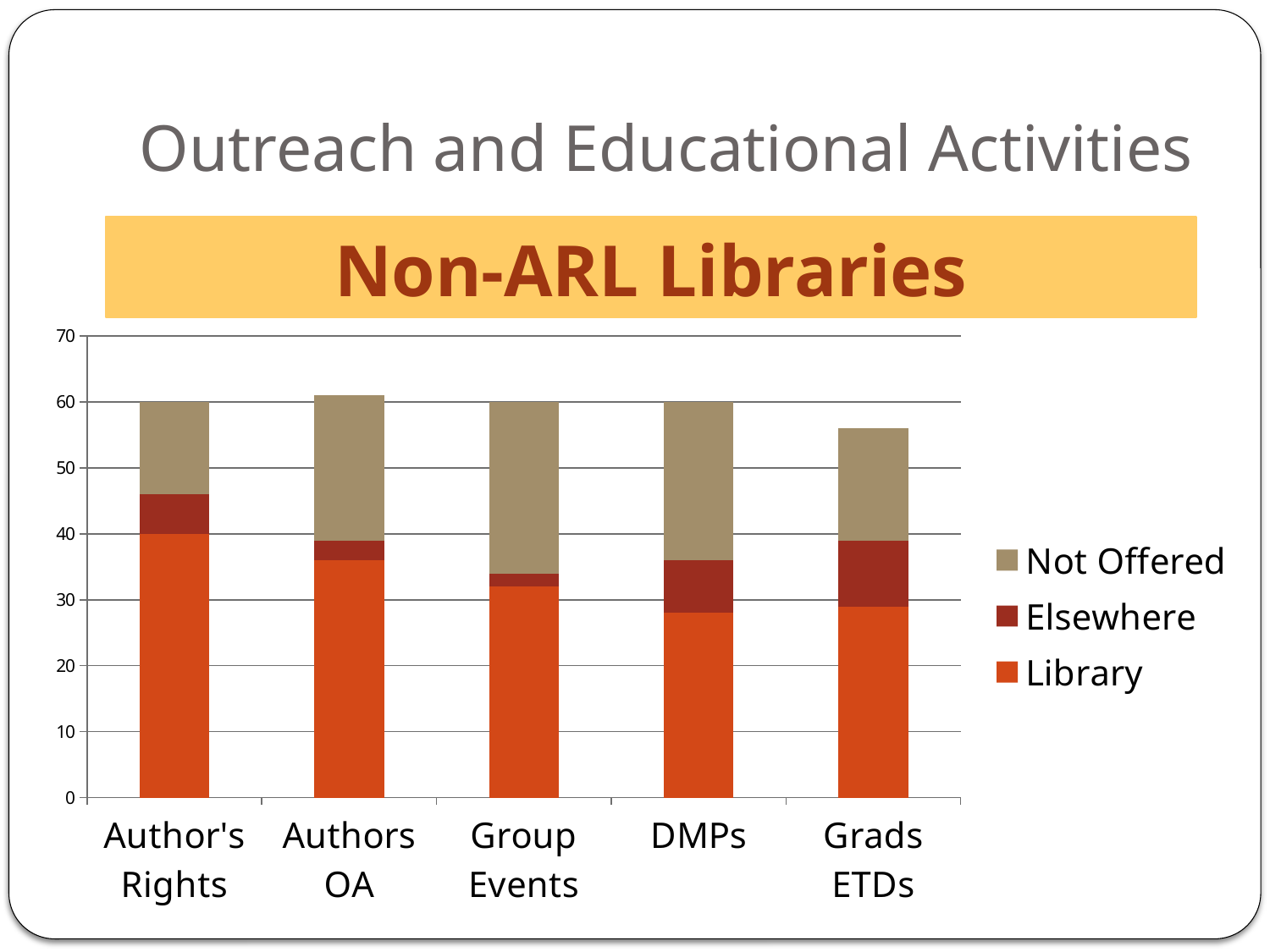
Is the total stacked bar for Grads ETDs greater or less than 60? less How many categories are shown on the x axis of the chart? 5 What is the total height of the stacked bar for Author's Rights? 60 Which series is shown in the tan colour at the top of each bar? Not Offered What is the Library value for Author's Rights? 40 What kind of chart is shown on the slide? Stacked bar chart Which category has the lowest total stacked bar? Grads ETDs Which category has the highest Library value? Author's Rights How many series does the chart's legend list? 3 Which has the larger Library value, Author's Rights or Authors OA? Author's Rights Is the Library value for DMPs greater or less than 30? less Is the Library value for Authors OA greater or less than 30? greater